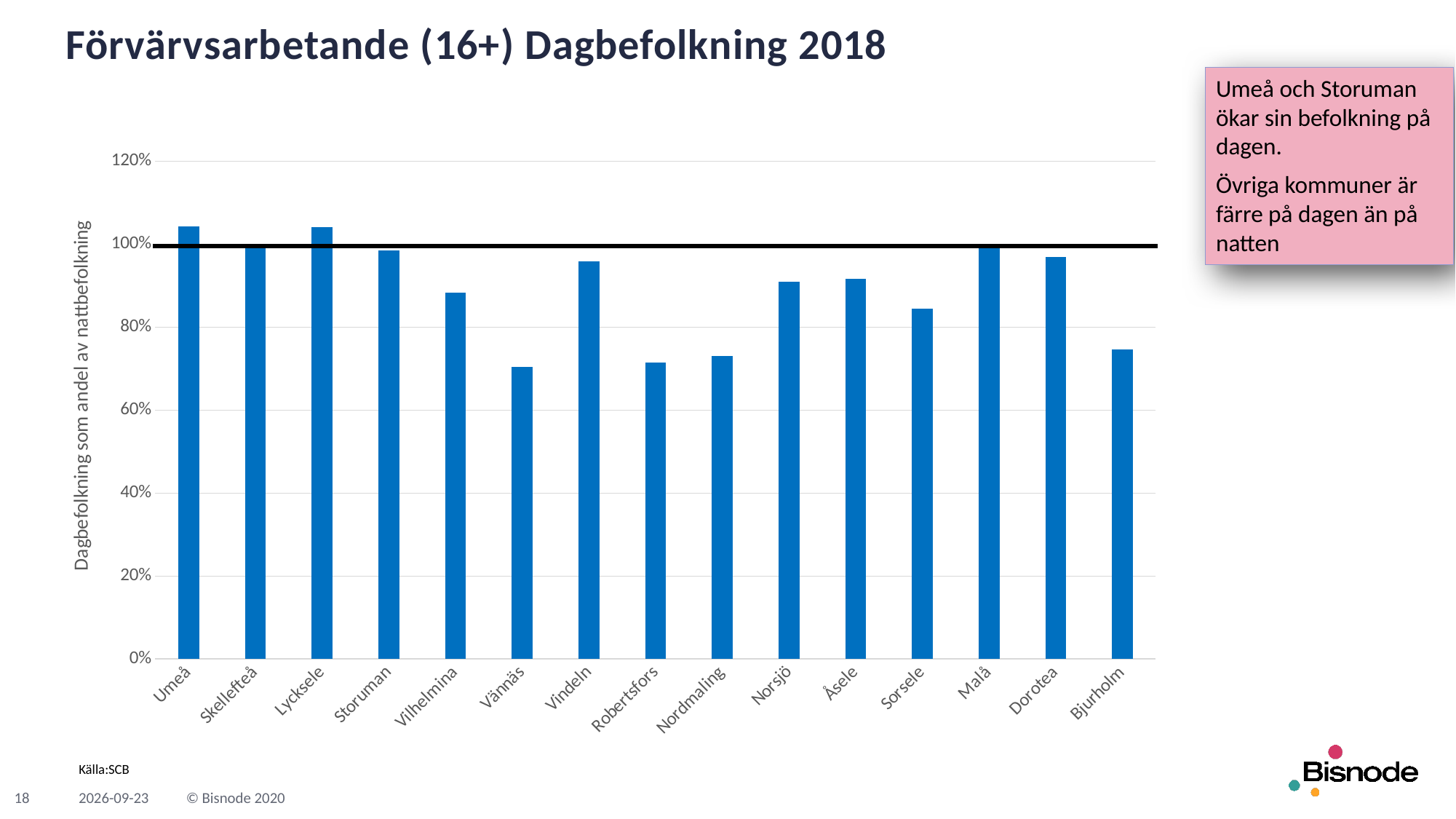
Is the value for Vännäs greater or less than 80%? less Is the value for Vilhelmina greater or less than 80%? greater Is the value for Norsjö greater or less than 80%? greater Which has the larger value, Dorotea or Nordmaling? Dorotea What is the title of the chart? Förvärvsarbetande (16+) Dagbefolkning 2018 What kind of chart is shown on the slide? bar chart What is the label on the vertical axis of the chart? Dagbefolkning som andel av nattbefolkning Which has the larger value, Vilhelmina or Vännäs? Vilhelmina How many municipalities are shown on the x axis of the chart? 15